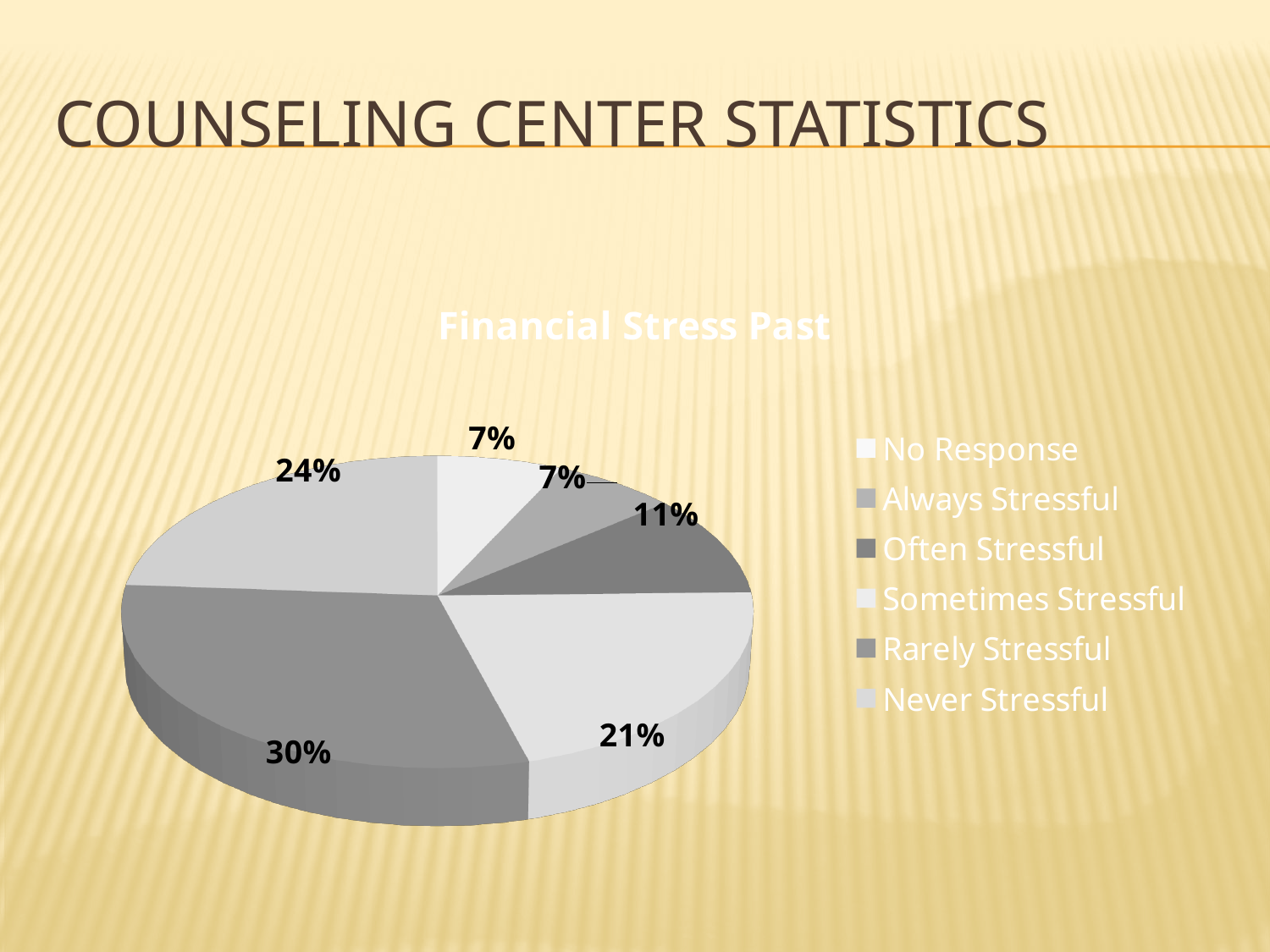
How many categories does the legend of the Financial Stress Past chart list? 6 What percentage of the Financial Stress Past pie is Often Stressful? 11% What type of chart is shown on the slide? pie chart What percentage of the Financial Stress Past pie is Always Stressful? 7% Which is larger in the Financial Stress Past chart, Never Stressful or Sometimes Stressful? Never Stressful What percentage of the Financial Stress Past pie is Rarely Stressful? 30% What percentage of the Financial Stress Past pie is Never Stressful? 24% Which legend entry is listed first in the Financial Stress Past chart? No Response Which category has the largest share of the Financial Stress Past pie? Rarely Stressful What is the difference in percentage points between Rarely Stressful and Often Stressful in the Financial Stress Past chart? 19 What is the title of the pie chart? Financial Stress Past What percentage of the Financial Stress Past pie is Sometimes Stressful? 21%